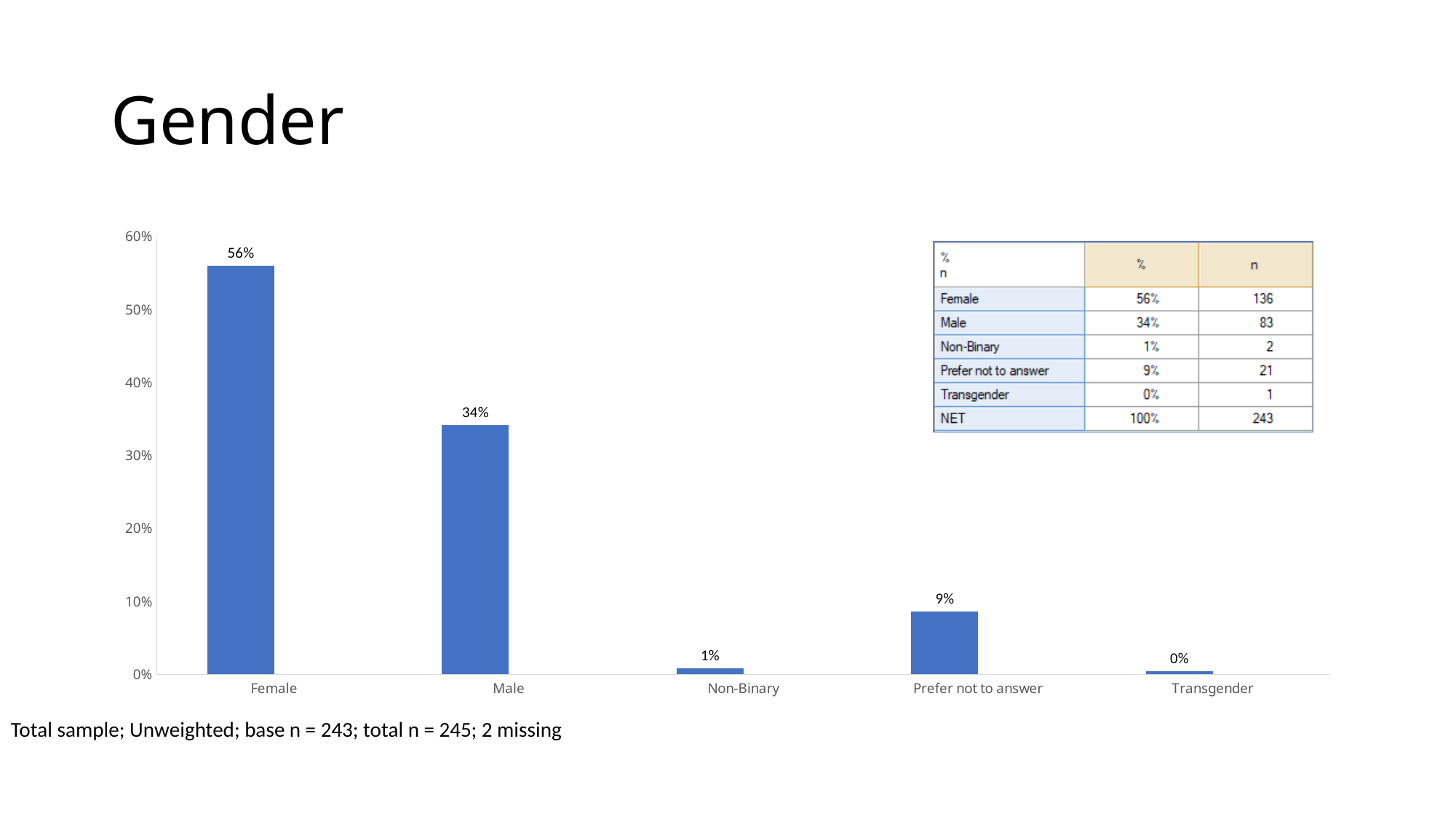
Which category has the lowest value? Transgender What kind of chart is shown on the slide? bar chart Is the value for Female greater or less than 50%? greater How many categories are shown on the x axis? 5 What is the difference between the values for Female and Male? 22% Which category has the highest value? Female What is the value for Male? 34% What is the value for Female? 56% What is the value for Non-Binary? 1% What is the title of the slide? Gender Which is larger, the value for Male or the value for Prefer not to answer? Male What is the value for Prefer not to answer? 9%